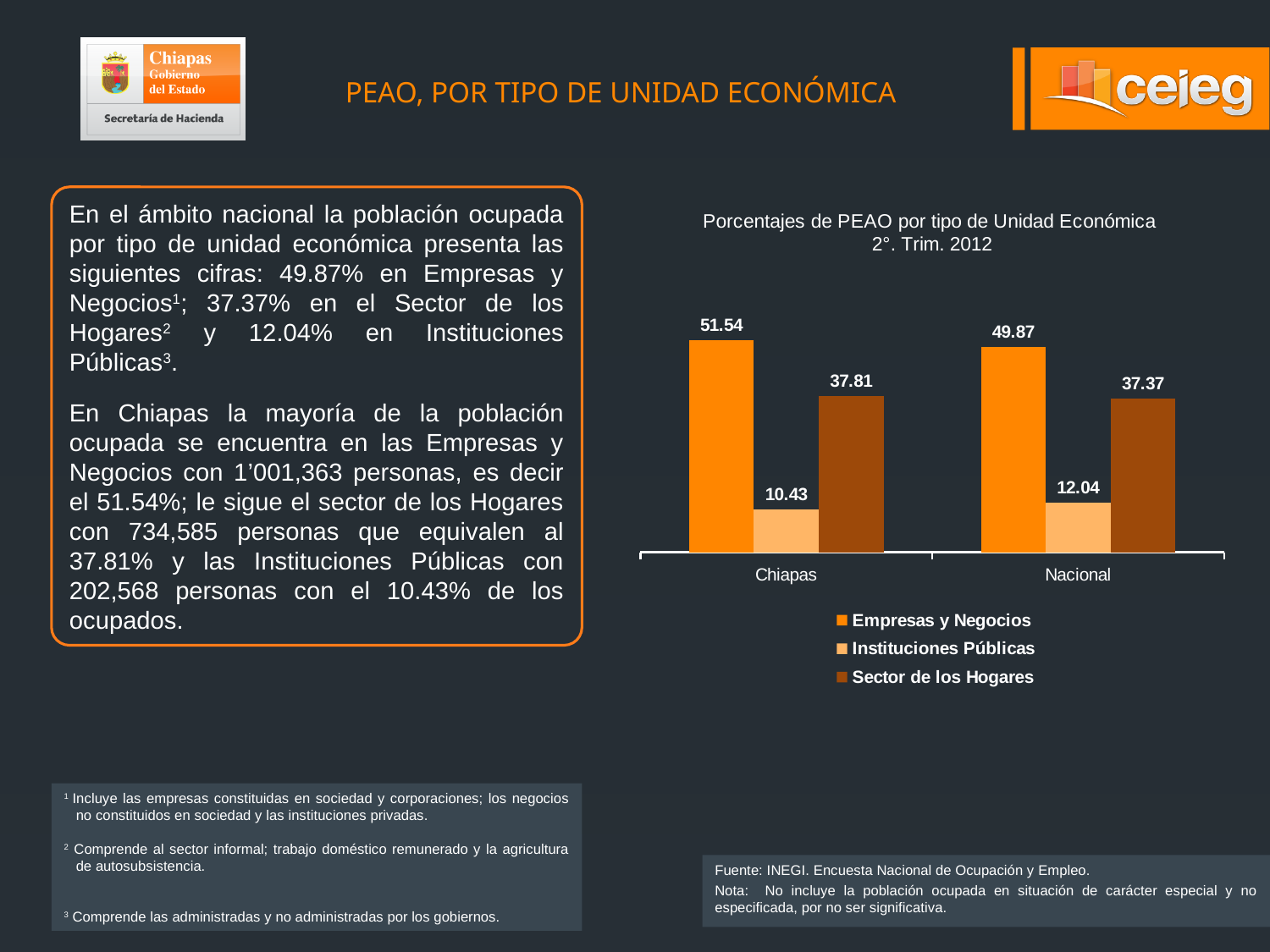
What is the value for Empresas y Negocios in Chiapas? 51.54 How many series does the legend list? 3 How many categories are shown on the x axis? 2 What is the difference between the Empresas y Negocios values for Chiapas and Nacional? 1.67 Which series has the highest value in Chiapas? Empresas y Negocios Which series has the lowest value in Nacional? Instituciones Públicas What is the value for Sector de los Hogares in Chiapas? 37.81 What kind of chart is shown on the slide? Bar chart What is the value for Sector de los Hogares in Nacional? 37.37 What is the title of the chart? Porcentajes de PEAO por tipo de Unidad Económica 2°. Trim. 2012 Which is larger, Instituciones Públicas in Chiapas or Instituciones Públicas in Nacional? Nacional What is the value for Instituciones Públicas in Nacional? 12.04